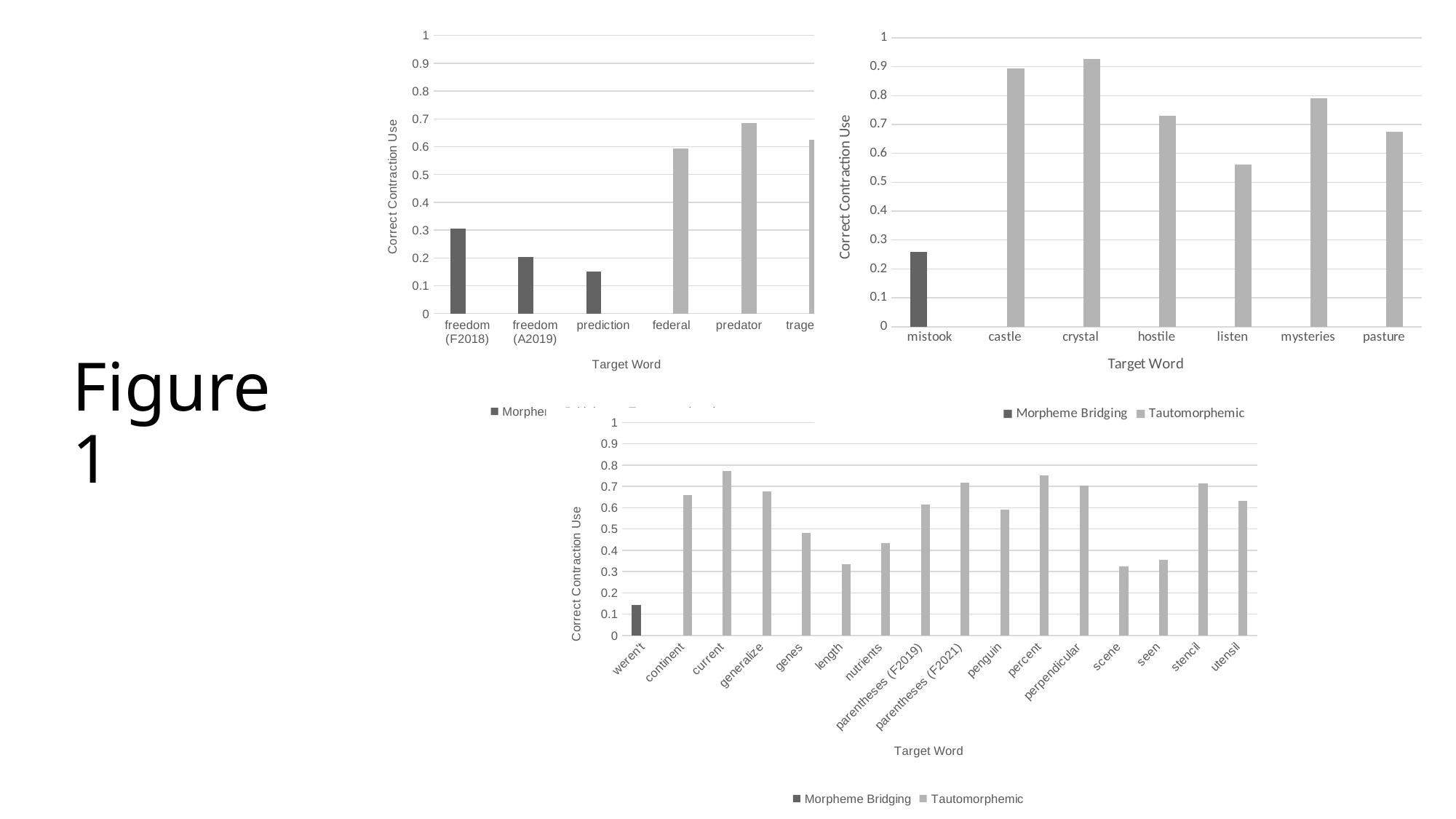
In the top-right chart, is the value for listen greater or less than 0.5? greater In the top-left chart, which has the higher value, freedom (F2018) or freedom (A2019)? freedom (F2018) In the bottom chart, is the value for length greater or less than 0.4? less In the top-right chart, which target word has the lowest correct contraction use? mistook In the top-right chart, which target word has the highest correct contraction use? crystal How many target words are shown on the x axis of the top-right chart? 7 What is the y-axis label of the bottom chart? Correct Contraction Use How many target words are shown on the x axis of the bottom chart? 16 In the bottom chart, which has the higher value, continent or genes? continent In the bottom chart, which target word has the lowest correct contraction use? weren't What kind of chart is the top-left chart? bar chart How many series does the legend of the top-right chart list? 2